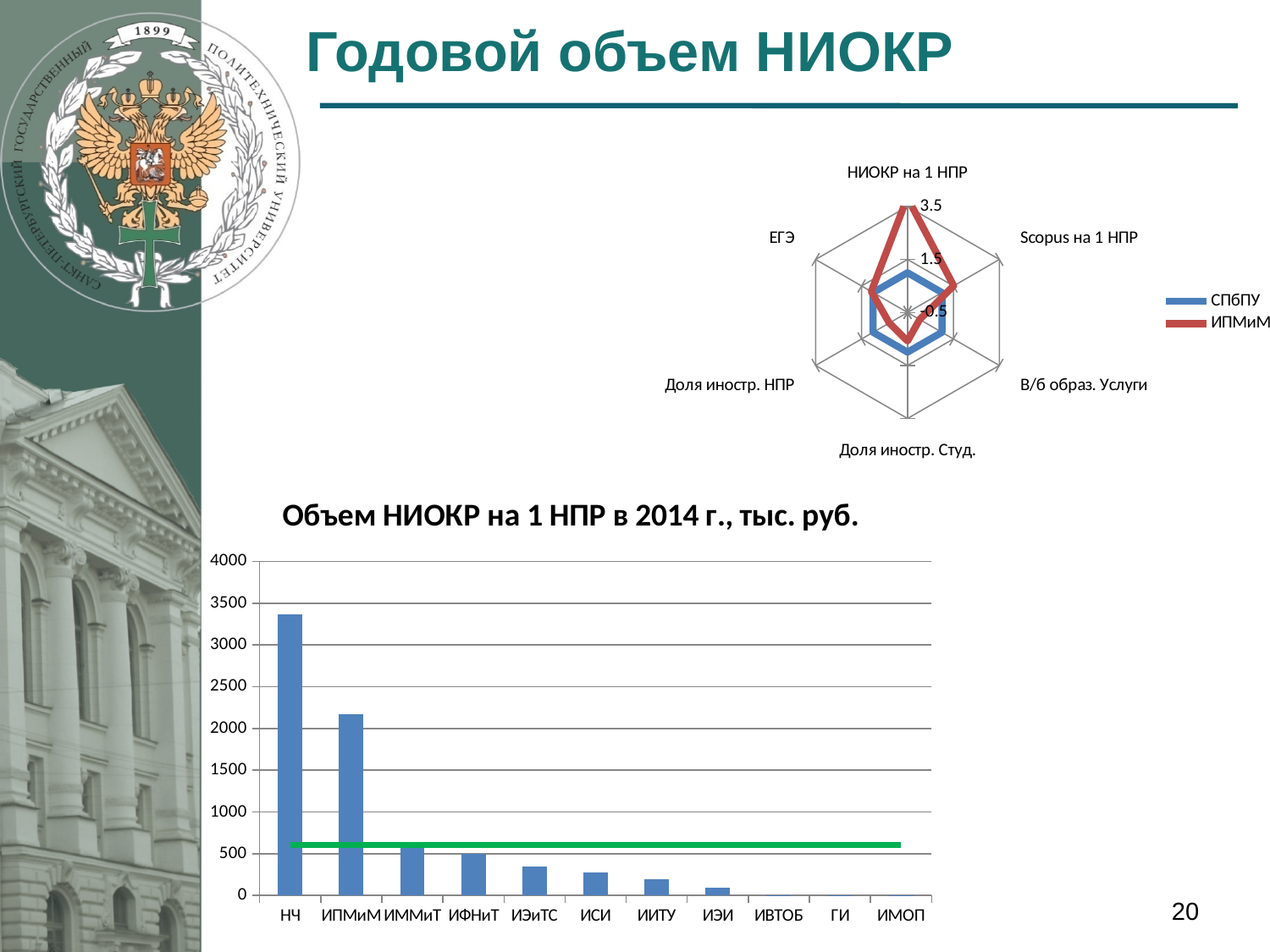
In the bar chart 'Объем НИОКР на 1 НПР в 2014 г., тыс. руб.', which category has the highest value? НЧ In the bar chart 'Объем НИОКР на 1 НПР в 2014 г., тыс. руб.', which is larger, the value for ИММиТ or the value for ИСИ? ИММиТ In the bar chart 'Объем НИОКР на 1 НПР в 2014 г., тыс. руб.', which is larger, the value for НЧ or the value for ИПМиМ? НЧ In the bar chart 'Объем НИОКР на 1 НПР в 2014 г., тыс. руб.', is the value for ИЭИ greater or less than 500? less In the bar chart 'Объем НИОКР на 1 НПР в 2014 г., тыс. руб.', is the value for НЧ greater or less than 3000? greater How many categories are shown on the x axis of the bar chart 'Объем НИОКР на 1 НПР в 2014 г., тыс. руб.'? 11 How many series does the legend of the radar chart 'НИОКР на 1 НПР' list? 2 In the bar chart 'Объем НИОКР на 1 НПР в 2014 г., тыс. руб.', is the value for ИПМиМ greater or less than 2000? greater In the radar chart 'НИОКР на 1 НПР', which series reaches the higher value on the 'НИОКР на 1 НПР' axis, СПбПУ or ИПМиМ? ИПМиМ What kind of chart is the chart titled 'Объем НИОКР на 1 НПР в 2014 г., тыс. руб.'? combination bar and line chart In the bar chart 'Объем НИОКР на 1 НПР в 2014 г., тыс. руб.', do the values rise or fall from left to right along the x axis? fall